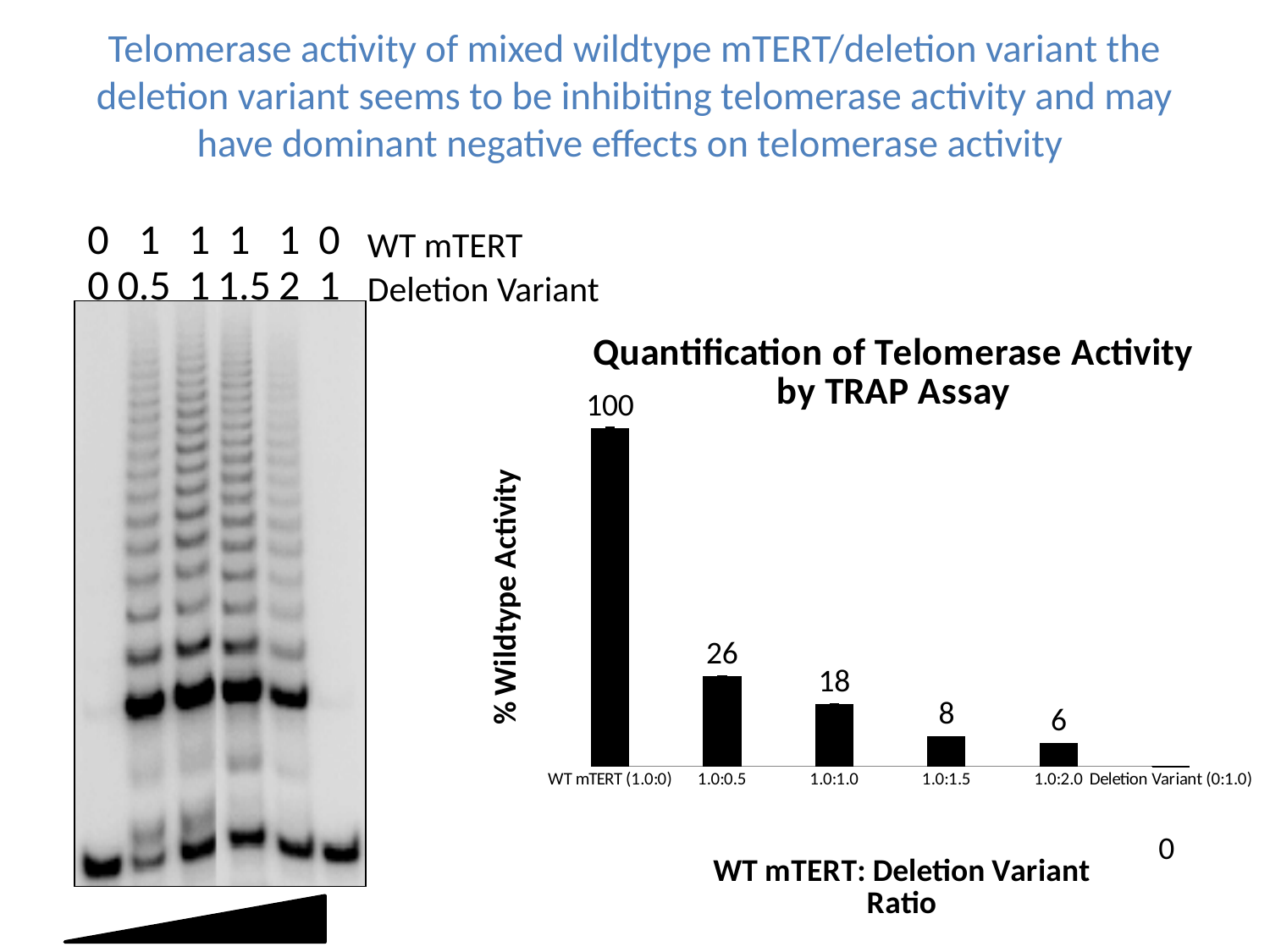
What is the value for the 1.0:1.0 ratio? 18 What is the value for the 1.0:0.5 ratio? 26 Which category has the highest value? WT mTERT (1.0:0) How many categories are plotted on the x axis? 6 Do the values rise or fall as the deletion variant ratio increases along the x axis? fall What is the value for WT mTERT (1.0:0)? 100 Which category has the lowest value? Deletion Variant (0:1.0) What is the title of the chart? Quantification of Telomerase Activity by TRAP Assay What type of chart is shown on the slide? bar chart What is the value for the 1.0:2.0 ratio? 6 Which is larger, the value for 1.0:1.5 or the value for 1.0:2.0? 1.0:1.5 What is the difference between the values for 1.0:0.5 and 1.0:1.0? 8